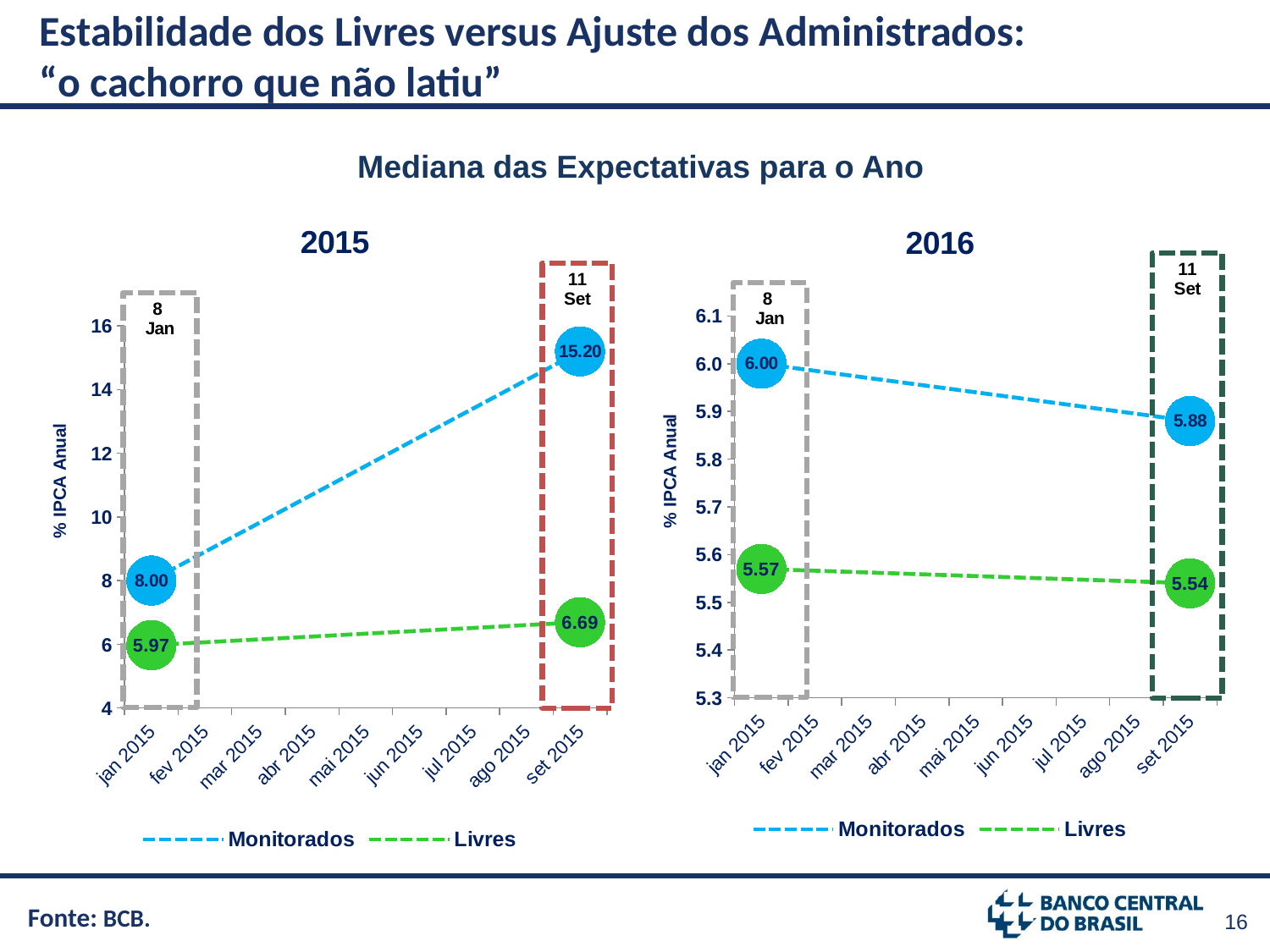
In the 2016 chart, which series has the higher value in jan 2015, Monitorados or Livres? Monitorados What is the y-axis label of the 2015 chart? % IPCA Anual What kind of chart is the 2016 chart? line chart In the 2016 chart, does the Livres series rise or fall from jan 2015 to set 2015? fall In the 2015 chart, what is the difference between the Monitorados values in set 2015 and jan 2015? 7.20 In the 2016 chart, what is the value for Monitorados in jan 2015? 6.00 In the 2015 chart, what is the value for Livres in jan 2015? 5.97 How many series does the legend of the 2015 chart list? 2 In the 2015 chart, what is the value for Monitorados in set 2015? 15.20 In the 2015 chart, does the Monitorados series rise or fall from jan 2015 to set 2015? rise In the 2016 chart, what is the difference between the Monitorados and Livres values in set 2015? 0.34 In the 2016 chart, what is the value for Livres in set 2015? 5.54